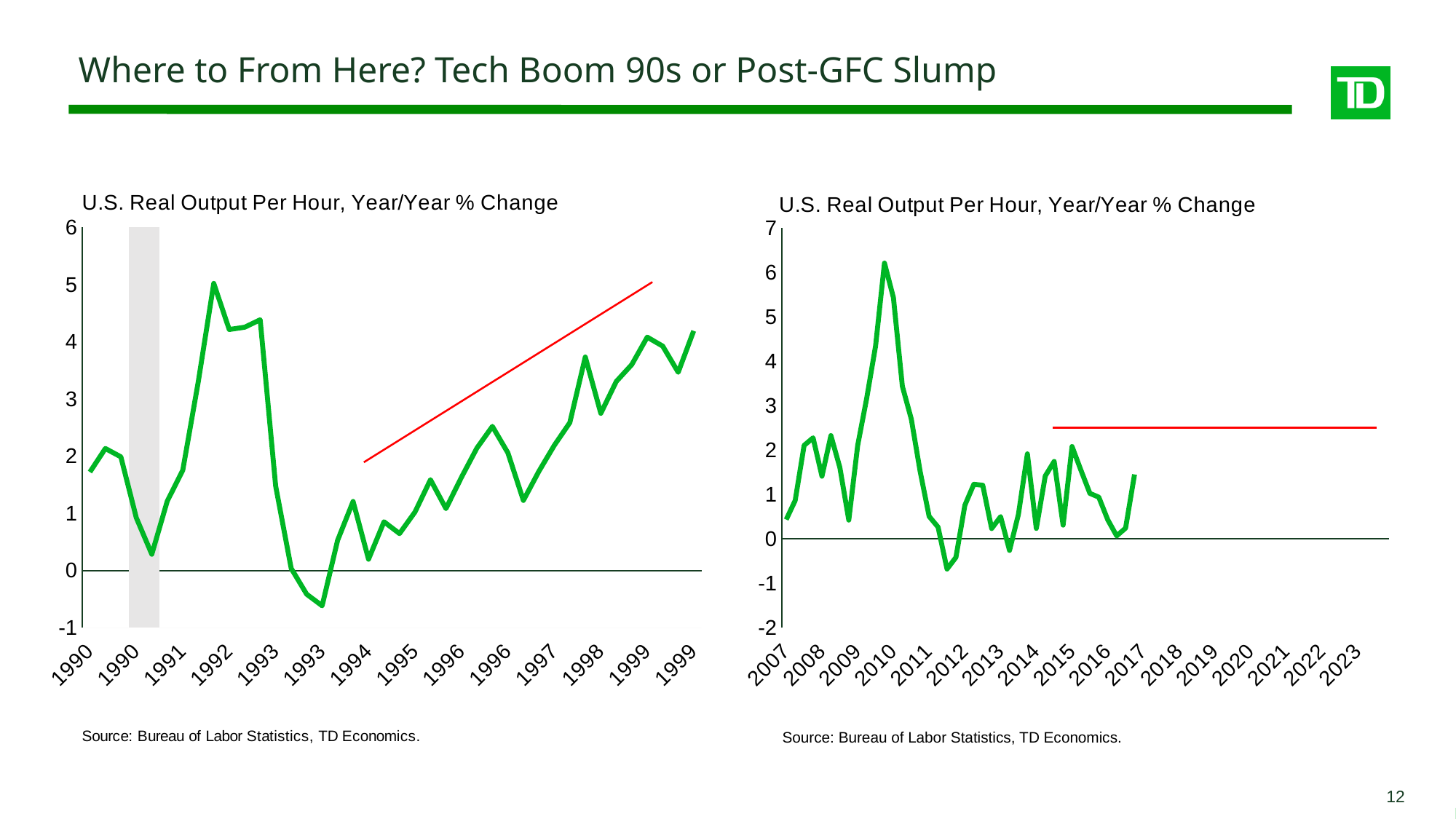
What is the highest value shown on the y axis of the right chart? 7 What is the title of the right chart? U.S. Real Output Per Hour, Year/Year % Change What kind of chart is the left chart on the slide? line chart On the left chart, do the values generally rise or fall from 1994 to 1999? rise On the right chart, is the peak value reached around 2010 greater or less than 5? greater On the left chart, is the value around 1990 (first point) greater or less than 3? less On the right chart, do the values rise or fall from 2010 to 2011? fall On the right chart, is the last plotted value (around 2017) greater or less than 1? greater How many year labels are shown on the x axis of the right chart? 17